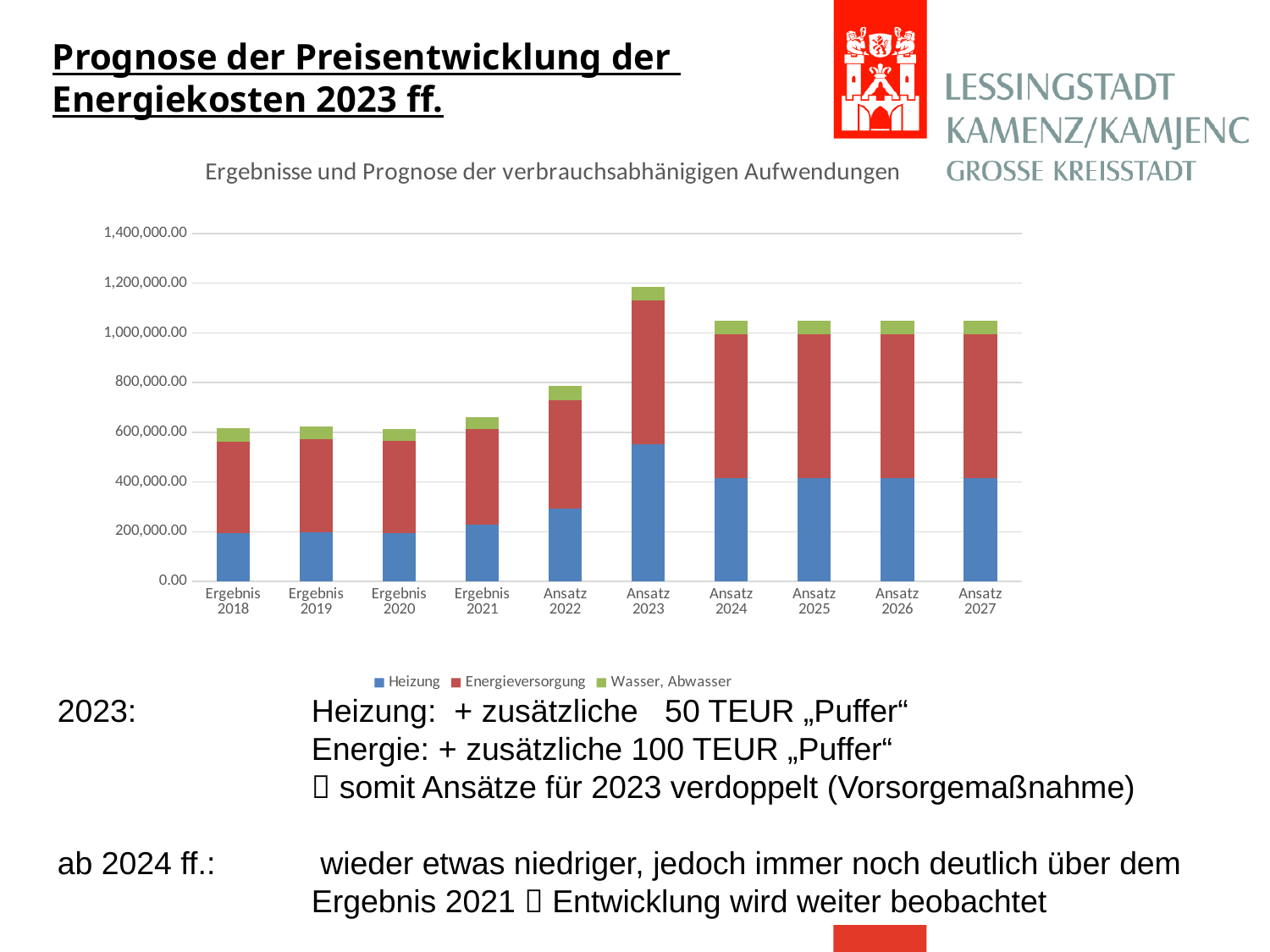
How many series does the chart legend list? 3 Do the total bars rise or fall from Ergebnis 2018 to Ansatz 2023? rise What kind of chart is shown on the slide? Stacked bar chart Is the total value for Ergebnis 2018 greater or less than 800,000.00? less What is the title of the chart? Ergebnisse und Prognose der verbrauchsabhänigigen Aufwendungen How many categories (years) are shown on the x axis of the chart? 10 Which has the larger total bar, Ansatz 2023 or Ansatz 2024? Ansatz 2023 Which category has the highest total bar in the chart? Ansatz 2023 Is the Heizung value for Ansatz 2023 greater or less than 400,000.00? greater Is the Heizung value for Ergebnis 2018 greater or less than 400,000.00? less